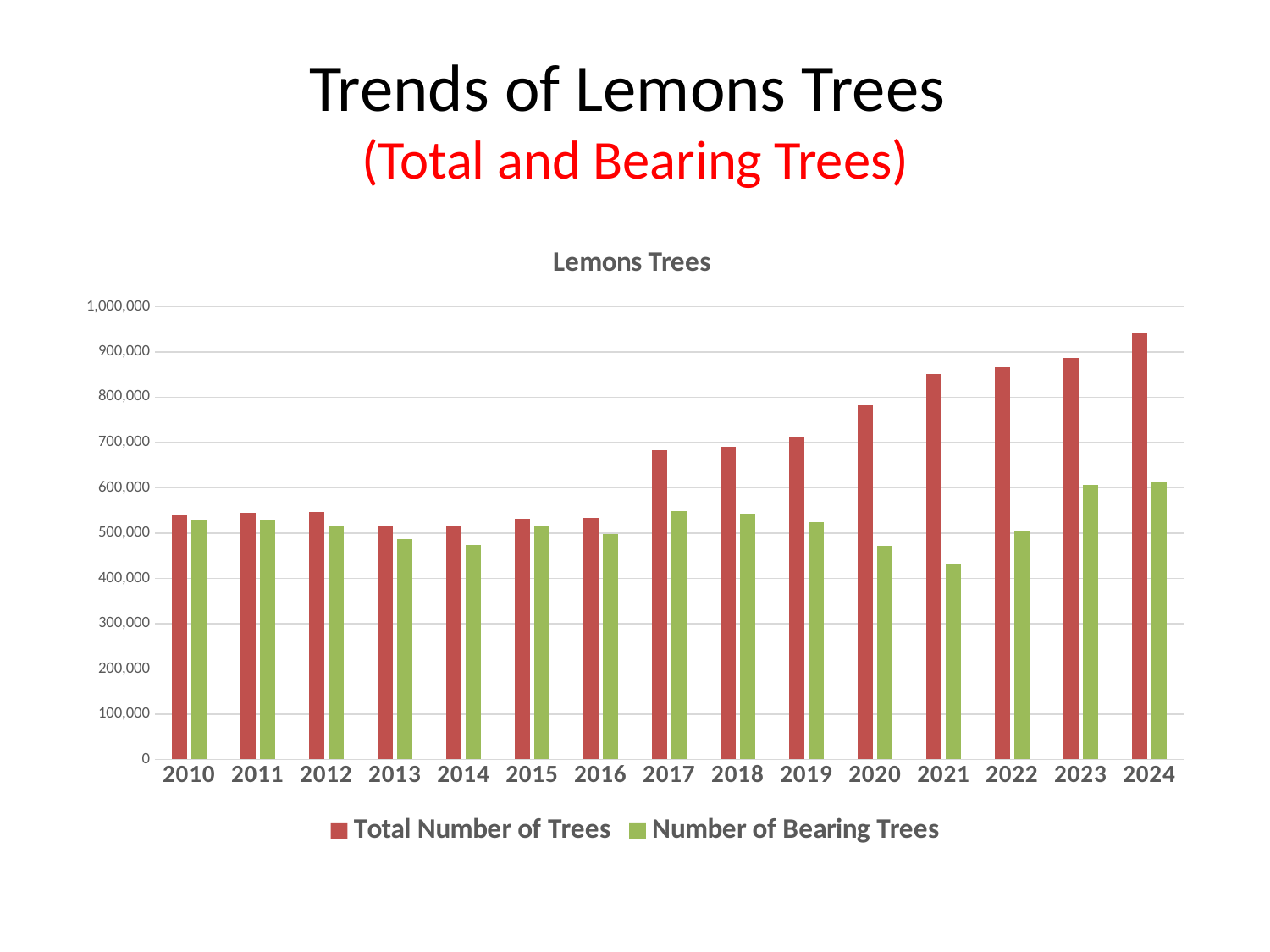
Is the Total Number of Trees for 2024 greater or less than 900,000? greater Which is larger, the Total Number of Trees in 2017 or in 2021? 2021 What kind of chart is shown on the slide? Bar chart Which year has the lowest Number of Bearing Trees? 2021 Is the Number of Bearing Trees for 2021 greater or less than 400,000? greater How many series does the legend list? 2 What is the title shown above the chart area? Lemons Trees How many years are shown on the x axis? 15 Is the Total Number of Trees for 2020 greater or less than 800,000? less Which year has the highest Total Number of Trees? 2024 Does the Total Number of Trees rise or fall from 2017 to 2024? Rise